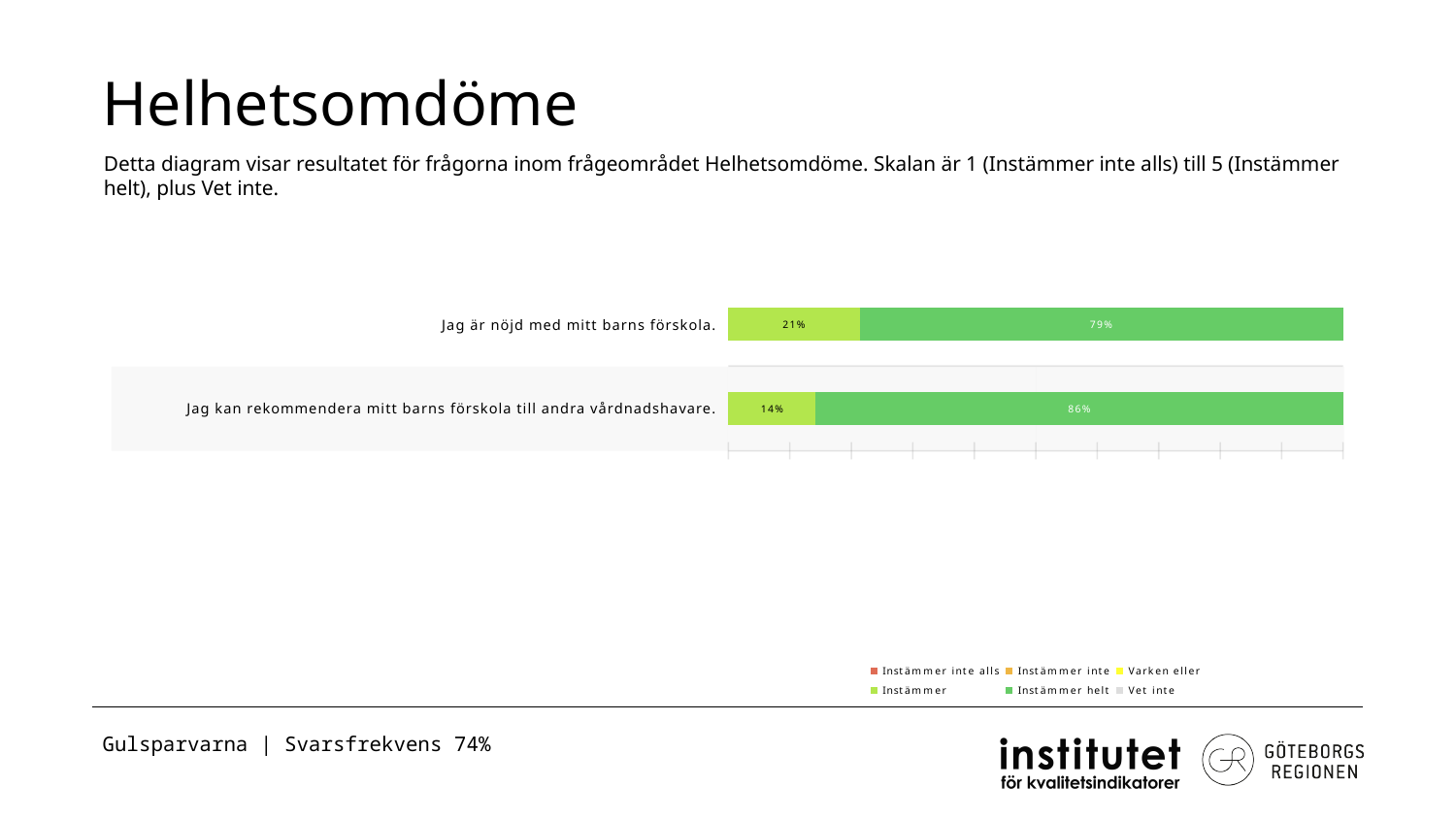
Which statement has the higher 'Instämmer helt' share? Jag kan rekommendera mitt barns förskola till andra vårdnadshavare. How many statements (categories) are plotted in the chart? 2 What is the 'Instämmer' value for 'Jag är nöjd med mitt barns förskola.'? 21% What kind of chart is shown on the slide? Stacked bar chart How many series does the chart legend list? 6 What is the 'Instämmer' value for 'Jag kan rekommendera mitt barns förskola till andra vårdnadshavare.'? 14% Is the 'Instämmer helt' value for 'Jag är nöjd med mitt barns förskola.' larger or smaller than its 'Instämmer' value? Larger What is the difference between the 'Instämmer helt' values of the two statements? 7% Which statement has the lower 'Instämmer' share? Jag kan rekommendera mitt barns förskola till andra vårdnadshavare. What is the 'Instämmer helt' value for 'Jag kan rekommendera mitt barns förskola till andra vårdnadshavare.'? 86% What is the 'Instämmer helt' value for 'Jag är nöjd med mitt barns förskola.'? 79% What is the total of the labelled segments in the bar for 'Jag är nöjd med mitt barns förskola.'? 100%